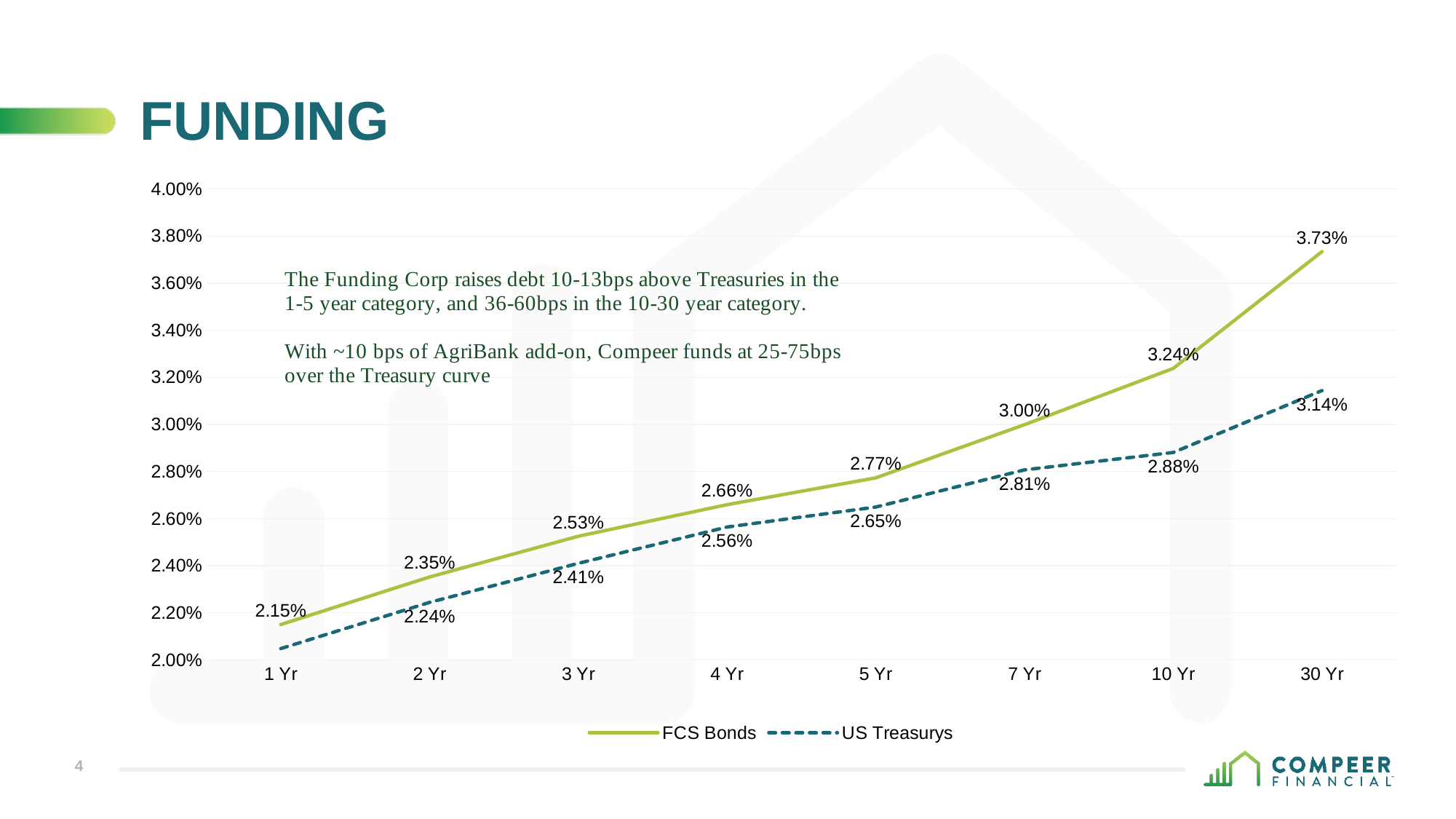
Which is larger at 7 Yr, FCS Bonds or US Treasurys? FCS Bonds What is the US Treasurys value at 10 Yr? 2.88% What is the difference between FCS Bonds and US Treasurys at 30 Yr? 0.59 percentage points At which maturity is the FCS Bonds value highest? 30 Yr At which maturity is the FCS Bonds value lowest? 1 Yr How many series does the legend list? 2 What is the FCS Bonds value at 1 Yr? 2.15% Is the US Treasurys value at 1 Yr greater or less than 2.20%? less What type of chart is shown on the slide? Line chart What is the FCS Bonds value at 30 Yr? 3.73% How many maturity categories are shown on the x axis? 8 Do the FCS Bonds values rise or fall as maturity increases along the x axis? Rise